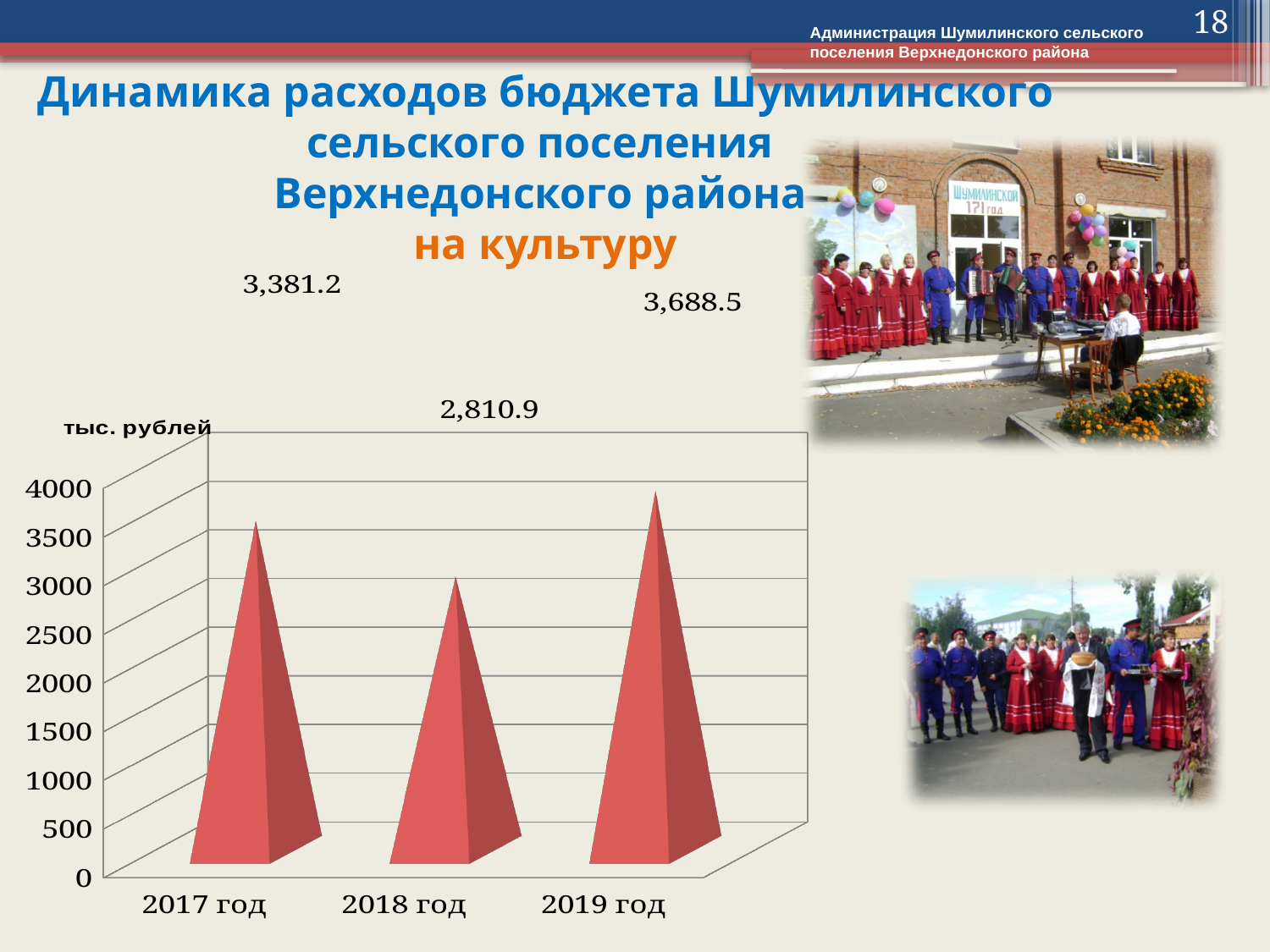
What is the difference between the values for 2019 год and 2018 год? 877.6 What is the value for 2017 год? 3,381.2 What unit is shown on the chart's vertical axis? тыс. рублей What is the value for 2018 год? 2,810.9 Which is larger, the value for 2017 год or the value for 2019 год? 2019 год Which year has the highest value? 2019 год Which year has the lowest value? 2018 год What is the difference between the values for 2017 год and 2018 год? 570.3 Is the value for 2018 год greater or less than 3000? less What is the value for 2019 год? 3,688.5 How many years are shown on the chart? 3 What kind of chart is shown on the slide? bar chart